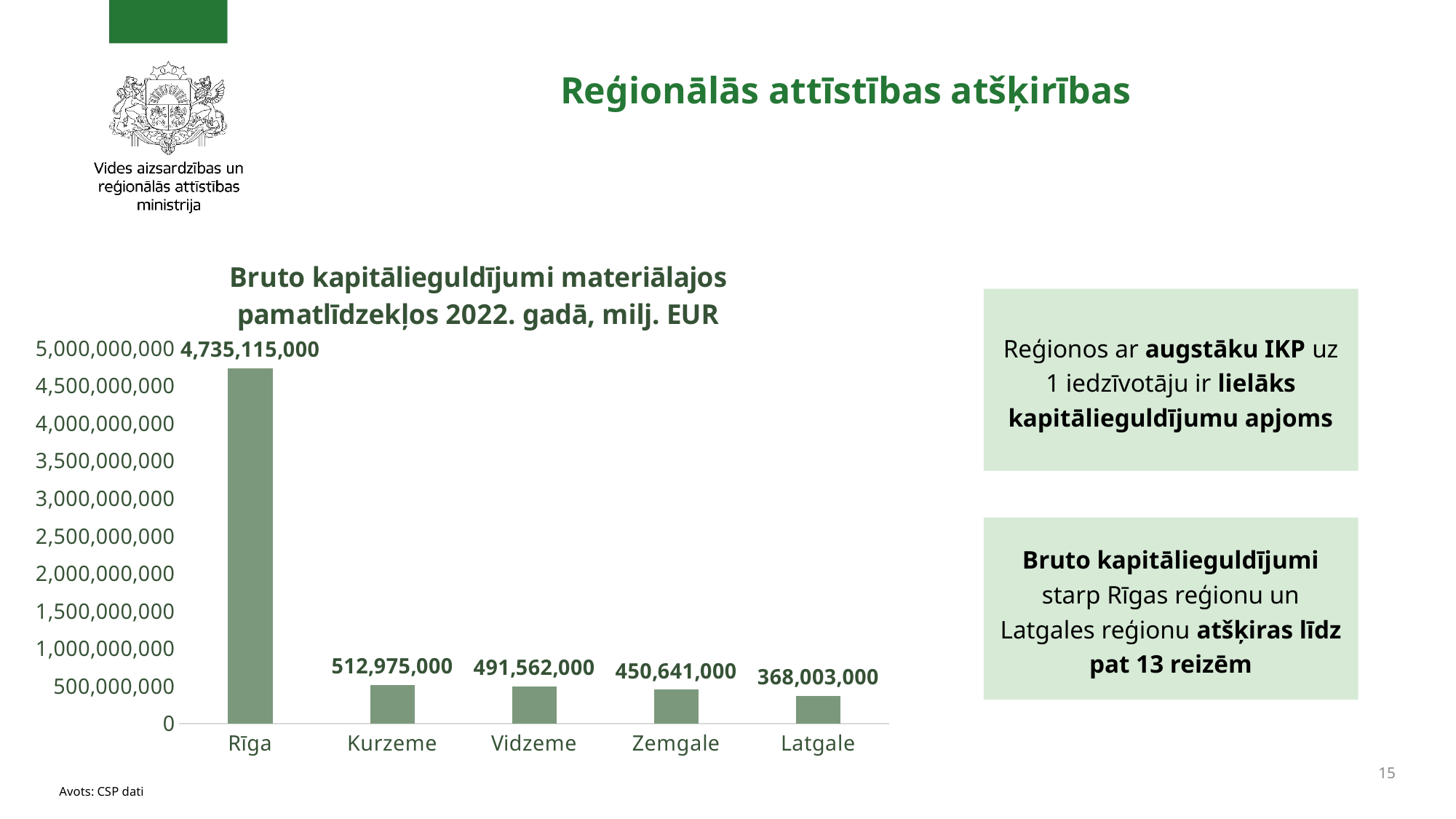
What is the difference between the values for Kurzeme and Vidzeme? 21,413,000 Which is larger, the value for Kurzeme or the value for Vidzeme? Kurzeme What kind of chart is shown on the slide? bar chart Which region has the lowest value in the chart? Latgale Which region has the highest value in the chart? Rīga What is the title of the chart? Bruto kapitālieguldījumi materiālajos pamatlīdzekļos 2022. gadā, milj. EUR Is the value for Rīga greater or less than 4,500,000,000? greater What is the value for Latgale in the chart? 368,003,000 What is the value for Rīga in the chart? 4,735,115,000 How many regions are shown in the chart? 5 What is the difference between the values for Rīga and Latgale? 4,367,112,000 What is the value for Zemgale in the chart? 450,641,000